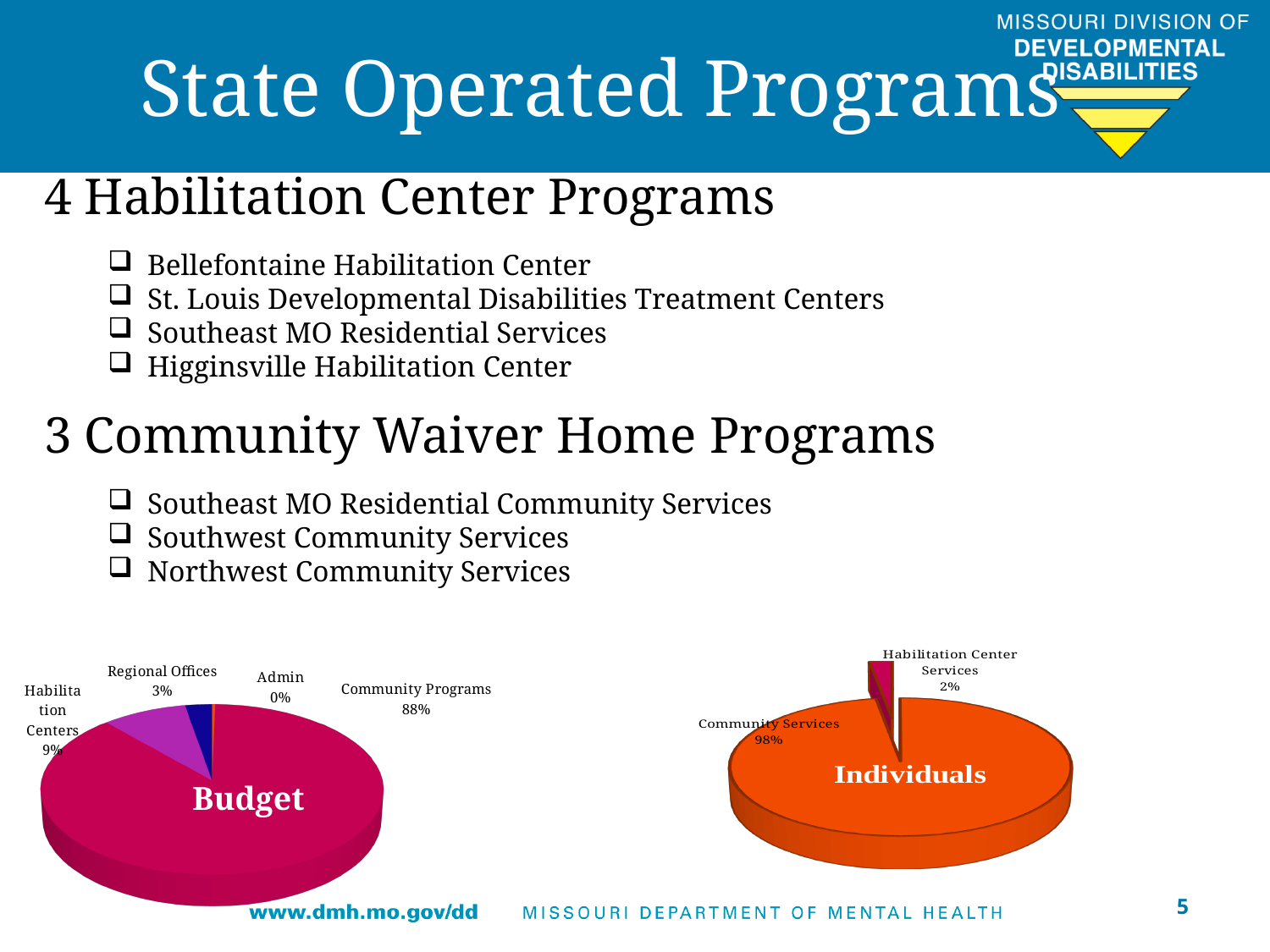
In the Budget pie chart, what share does Habilitation Centers have? 9% In the Budget pie chart, what share does Community Programs have? 88% What kind of chart is the Budget chart on the left? pie chart In the Individuals pie chart on the right, what share does Community Services have? 98% In the Budget pie chart, what share does Regional Offices have? 3% In the Individuals pie chart on the right, which is larger, Community Services or Habilitation Center Services? Community Services In the Budget pie chart, which category has the smallest share? Admin In the Budget pie chart, how many categories are shown? 4 In the Budget pie chart, what share does Admin have? 0% In the Individuals pie chart on the right, what share does Habilitation Center Services have? 2% In the Budget pie chart, what is the difference between the Community Programs share and the Habilitation Centers share? 79% In the Budget pie chart, which category has the largest share? Community Programs